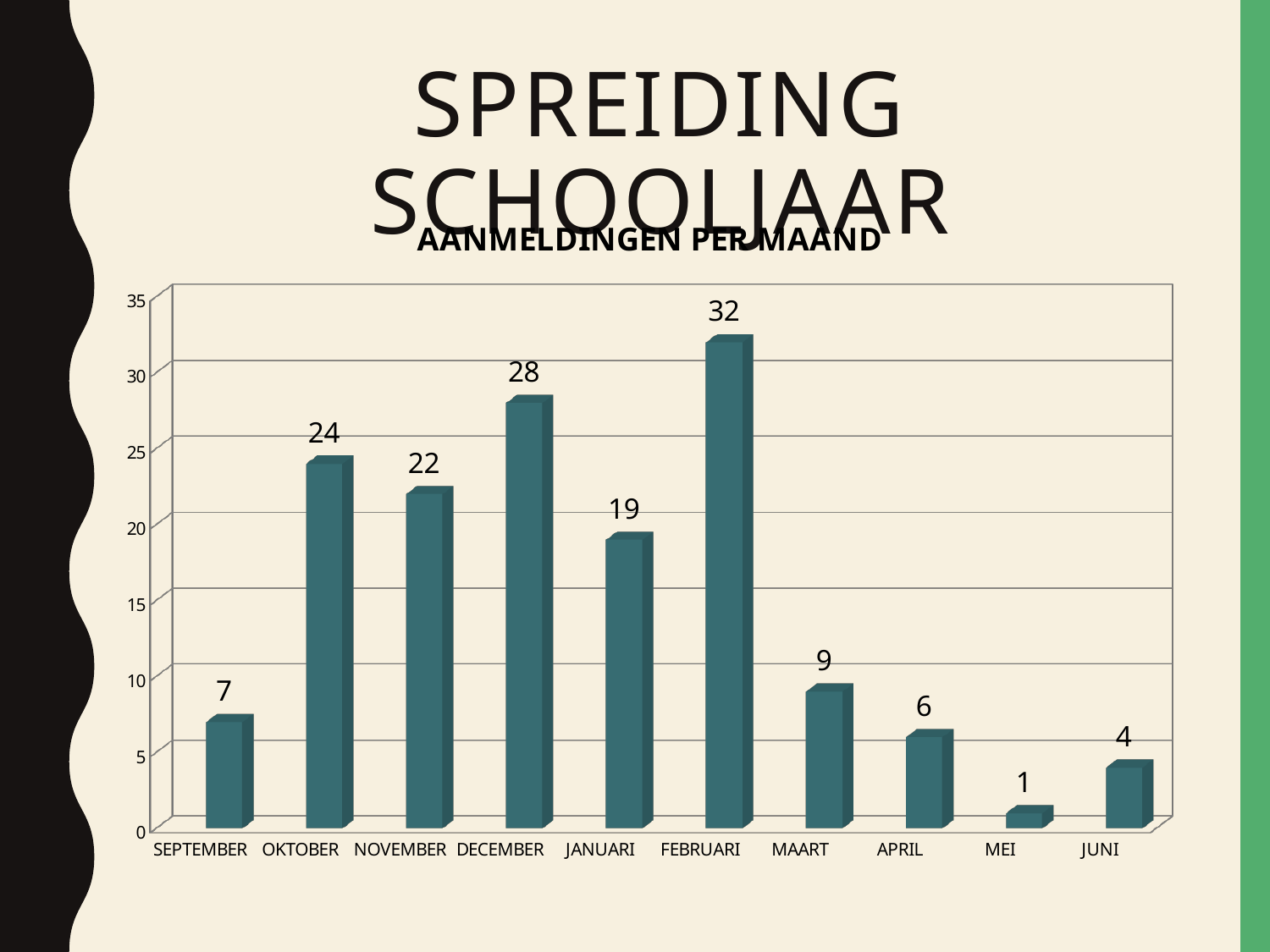
What kind of chart is shown on the slide? bar chart What is the value for FEBRUARI? 32 How many months are shown on the x axis? 10 What is the difference between the values for FEBRUARI and SEPTEMBER? 25 What is the value for MAART? 9 Which month has the lowest value? MEI Which is larger, the value for OKTOBER or the value for NOVEMBER? OKTOBER Which month has the highest value? FEBRUARI What is the title of the chart? AANMELDINGEN PER MAAND What is the difference between the values for DECEMBER and JANUARI? 9 What is the value for SEPTEMBER? 7 Is the value for DECEMBER greater or less than 25? greater